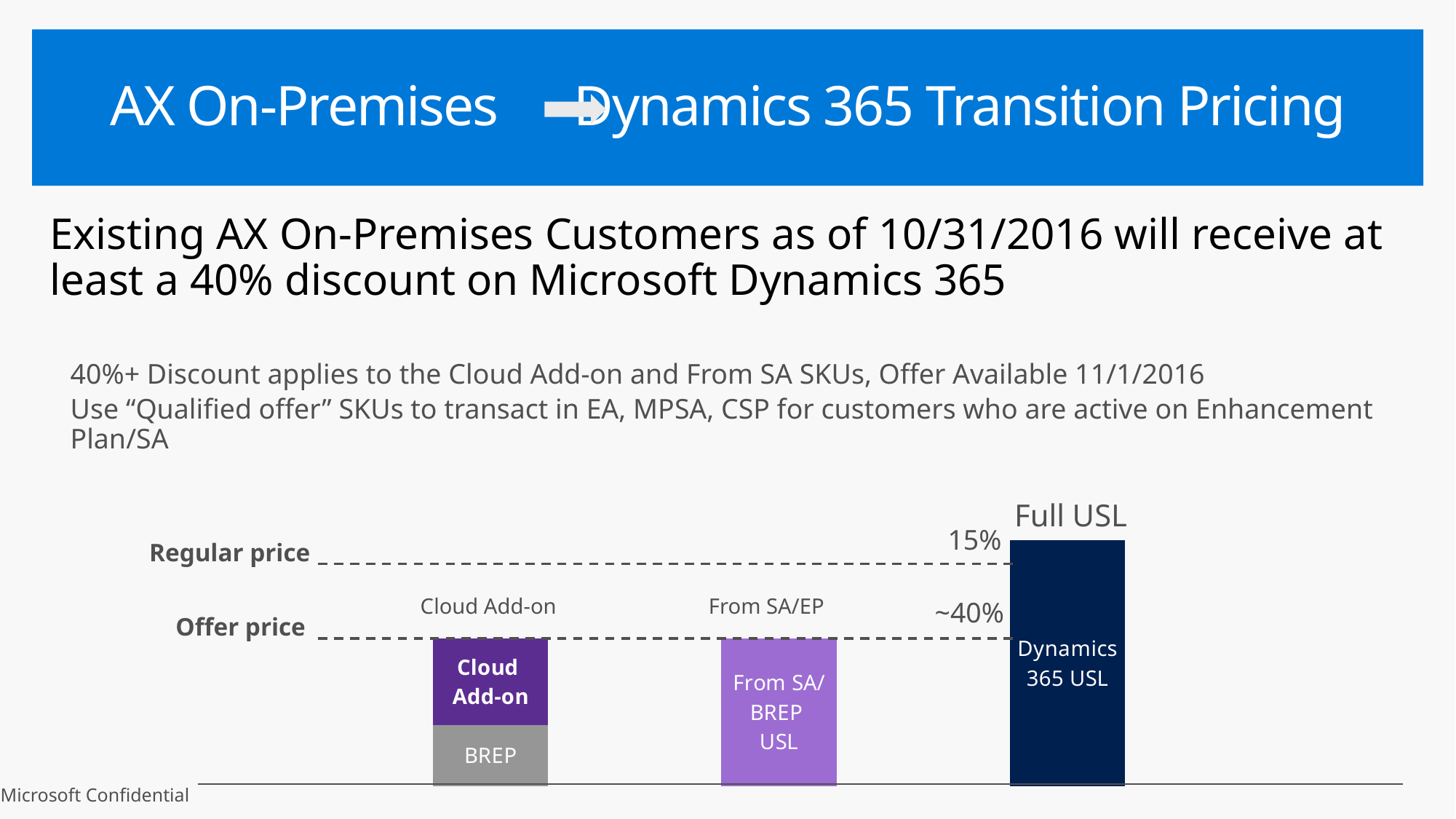
What percentage label is printed next to the Full USL bar above the Regular price line? 15% What kind of chart is shown at the bottom of the slide? Bar chart What is the label of the bottom segment of the Cloud Add-on bar? BREP Which bar in the chart is the tallest? Full USL (Dynamics 365 USL) Which bar is taller, Full USL or From SA/EP? Full USL What percentage label is printed between the Regular price and Offer price lines next to the Full USL bar? ~40% How many bars are shown in the chart? 3 Which bar is taller, Full USL or Cloud Add-on? Full USL What is the label inside the Full USL bar? Dynamics 365 USL Which bar in the chart is made up of two stacked segments? Cloud Add-on What are the two dashed horizontal lines in the chart labelled? Regular price and Offer price